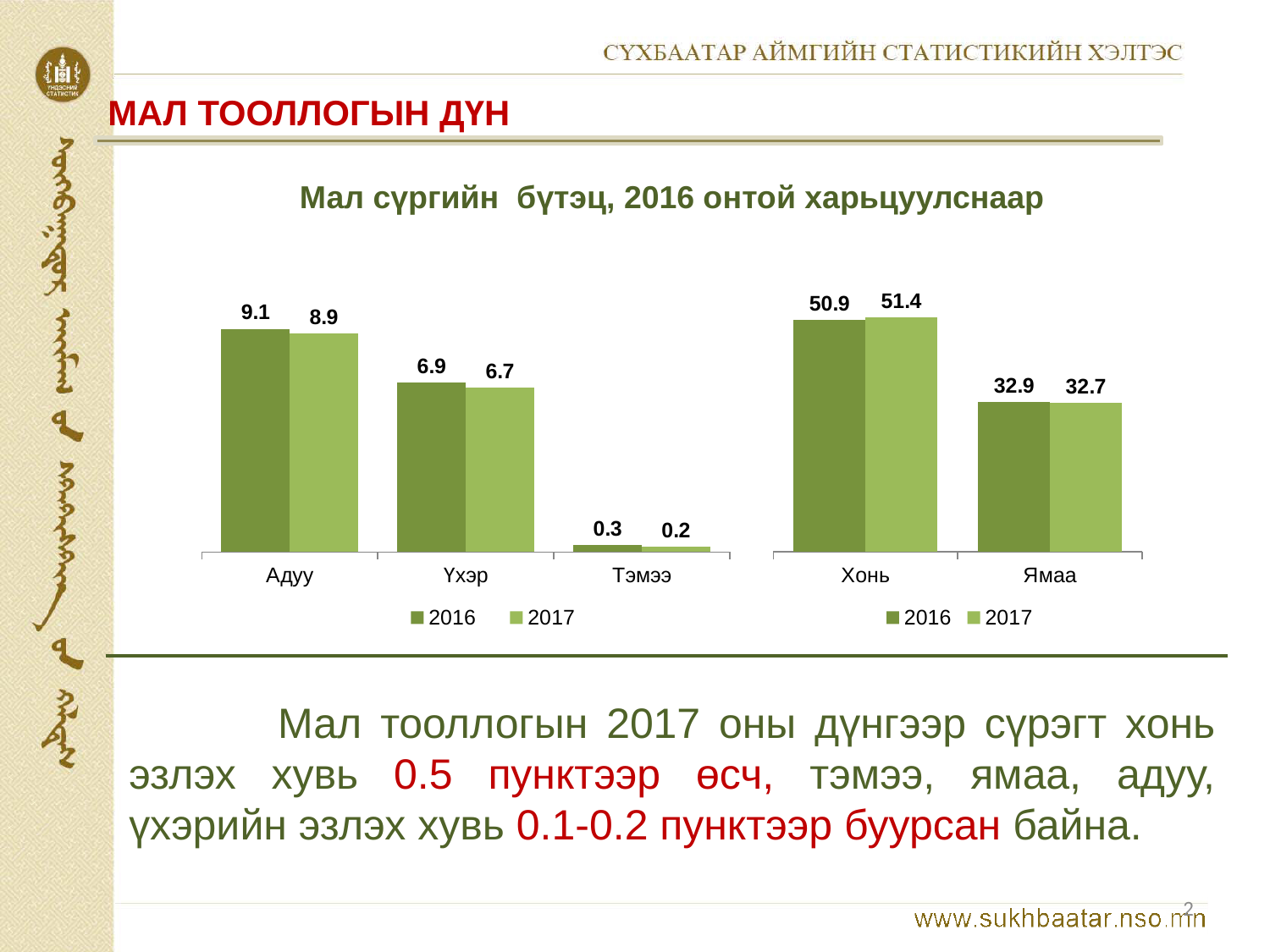
In the right chart, what is the value for Ямаа in 2016? 32.9 How many categories are shown in the left chart? 3 What type of chart is the left chart? bar chart In the left chart, which category has the lowest value in 2017? Тэмээ In the right chart, what is the difference between the 2017 and 2016 values for Хонь? 0.5 In the right chart, which category has the highest value in 2016? Хонь In the left chart, is the 2016 value for Үхэр larger or smaller than the 2017 value for Үхэр? larger How many series does the legend of the right chart list? 2 In the left chart, what is the value for Үхэр in 2017? 6.7 In the left chart, what is the value for Адуу in 2016? 9.1 In the right chart, what is the value for Хонь in 2017? 51.4 In the left chart, what is the difference between the 2016 and 2017 values for Адуу? 0.2